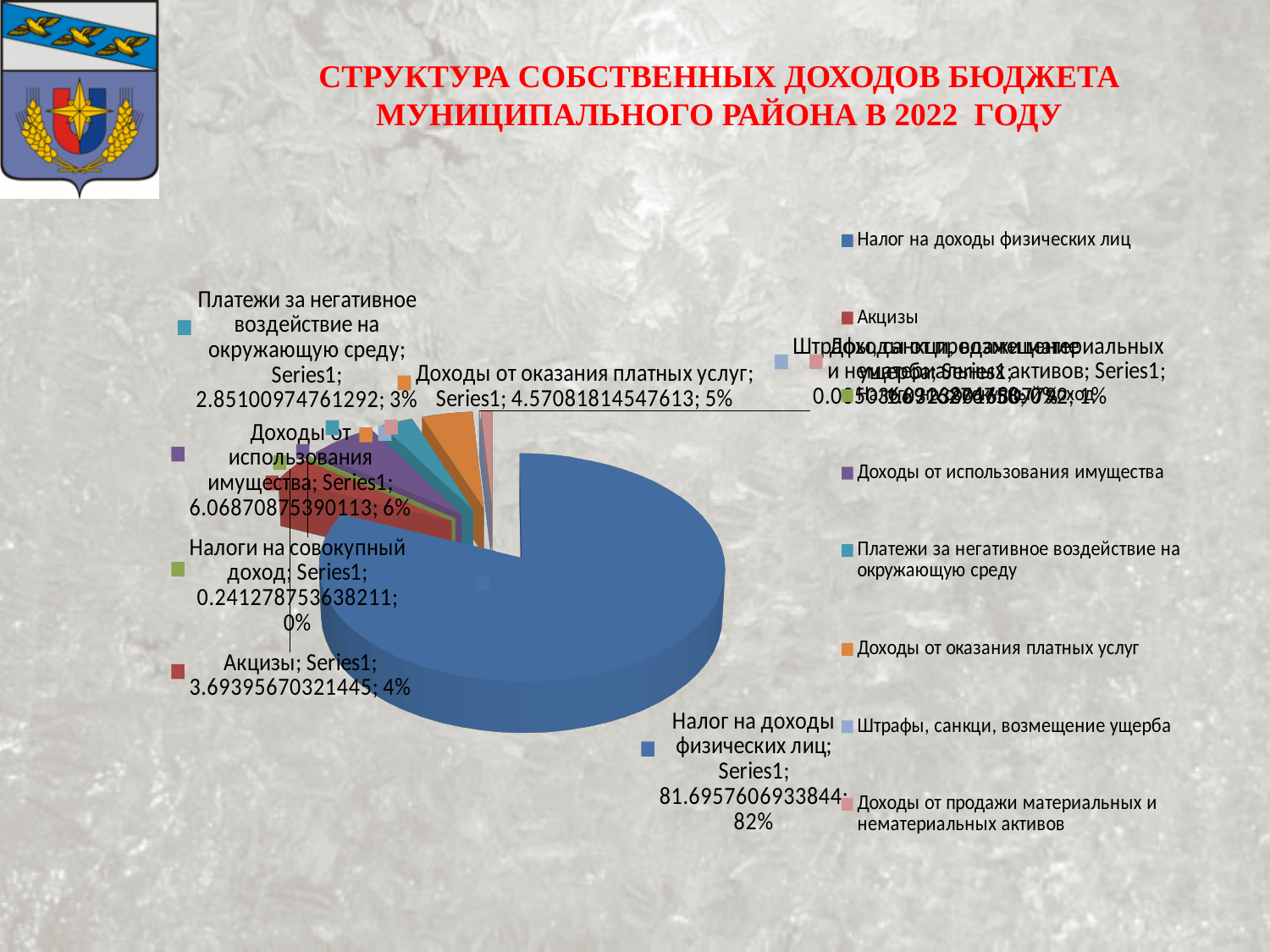
Which category has the largest share of the pie? Налог на доходы физических лиц What is the difference in percentage points between the share for Налог на доходы физических лиц and the share for Доходы от использования имущества? 76 How many categories does the legend list? 8 What value is printed for Налоги на совокупный доход? 0.241278753638211 What percentage share is shown for Акцизы? 4% Which is larger: the share for Доходы от использования имущества or the share for Акцизы? Доходы от использования имущества What is the title of the slide containing the chart? СТРУКТУРА СОБСТВЕННЫХ ДОХОДОВ БЮДЖЕТА МУНИЦИПАЛЬНОГО РАЙОНА В 2022 ГОДУ What percentage share is shown for Платежи за негативное воздействие на окружающую среду? 3% What percentage share is shown for Налог на доходы физических лиц? 82% What kind of chart is shown on the slide? pie chart